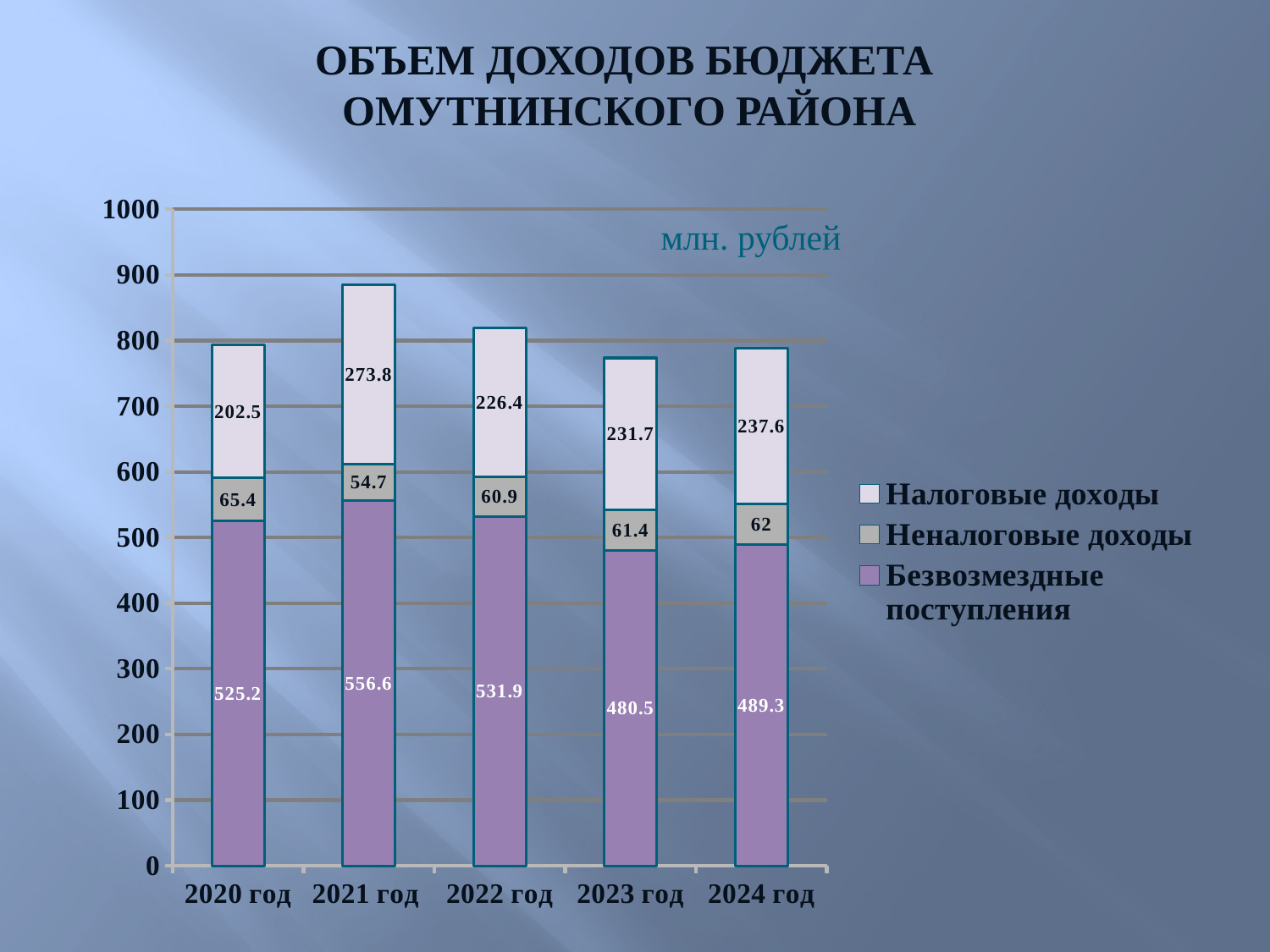
How many years are shown on the x axis? 5 What is the value of Налоговые доходы for 2021 год? 273.8 Which is larger: Безвозмездные поступления in 2022 год or in 2024 год? 2022 год What kind of chart is shown on the slide? Stacked bar chart What is the total of the stacked bar for 2023 год? 773.6 How many series does the legend list? 3 What is the total of the stacked bar for 2021 год? 885.1 What is the difference between Налоговые доходы in 2021 год and 2020 год? 71.3 What is the value of Безвозмездные поступления for 2023 год? 480.5 Which year has the lowest value for Неналоговые доходы? 2021 год Which year has the highest value for Безвозмездные поступления? 2021 год What is the value of Неналоговые доходы for 2024 год? 62